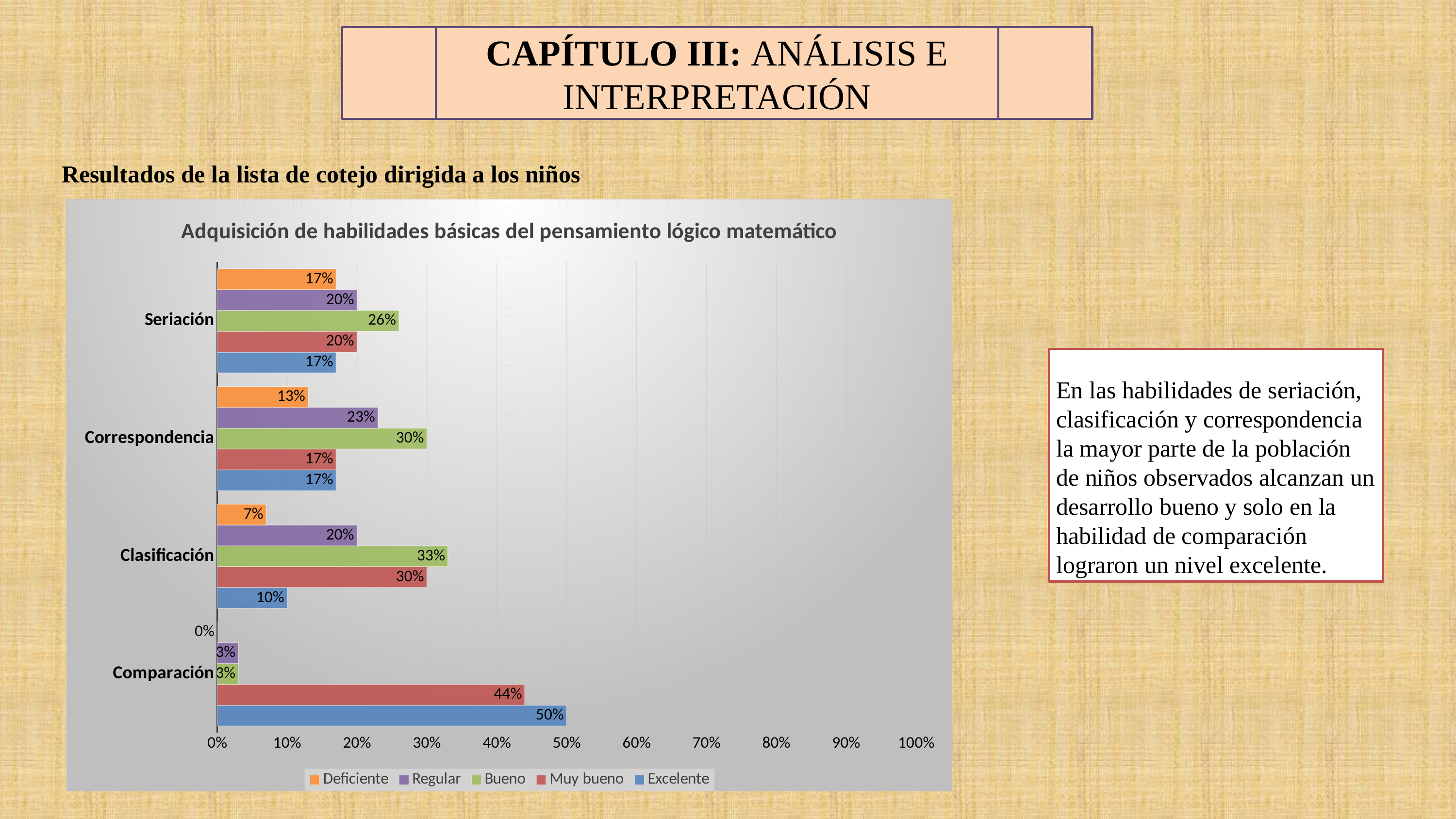
Which category has the lowest Deficiente value? Comparación How many series does the legend list? 5 How many categories are shown on the vertical axis of the chart? 4 Which series is shown in orange in the legend? Deficiente What is the Deficiente value for Correspondencia? 13% What is the Bueno value for Clasificación? 33% What kind of chart is shown on the slide? Bar chart What is the difference between the Bueno value for Correspondencia and the Bueno value for Seriación? 4% Which is larger: the Regular value for Correspondencia or the Regular value for Clasificación? Correspondencia What is the Excelente value for Comparación? 50% Which category has the highest Muy bueno value? Comparación What is the title of the chart? Adquisición de habilidades básicas del pensamiento lógico matemático